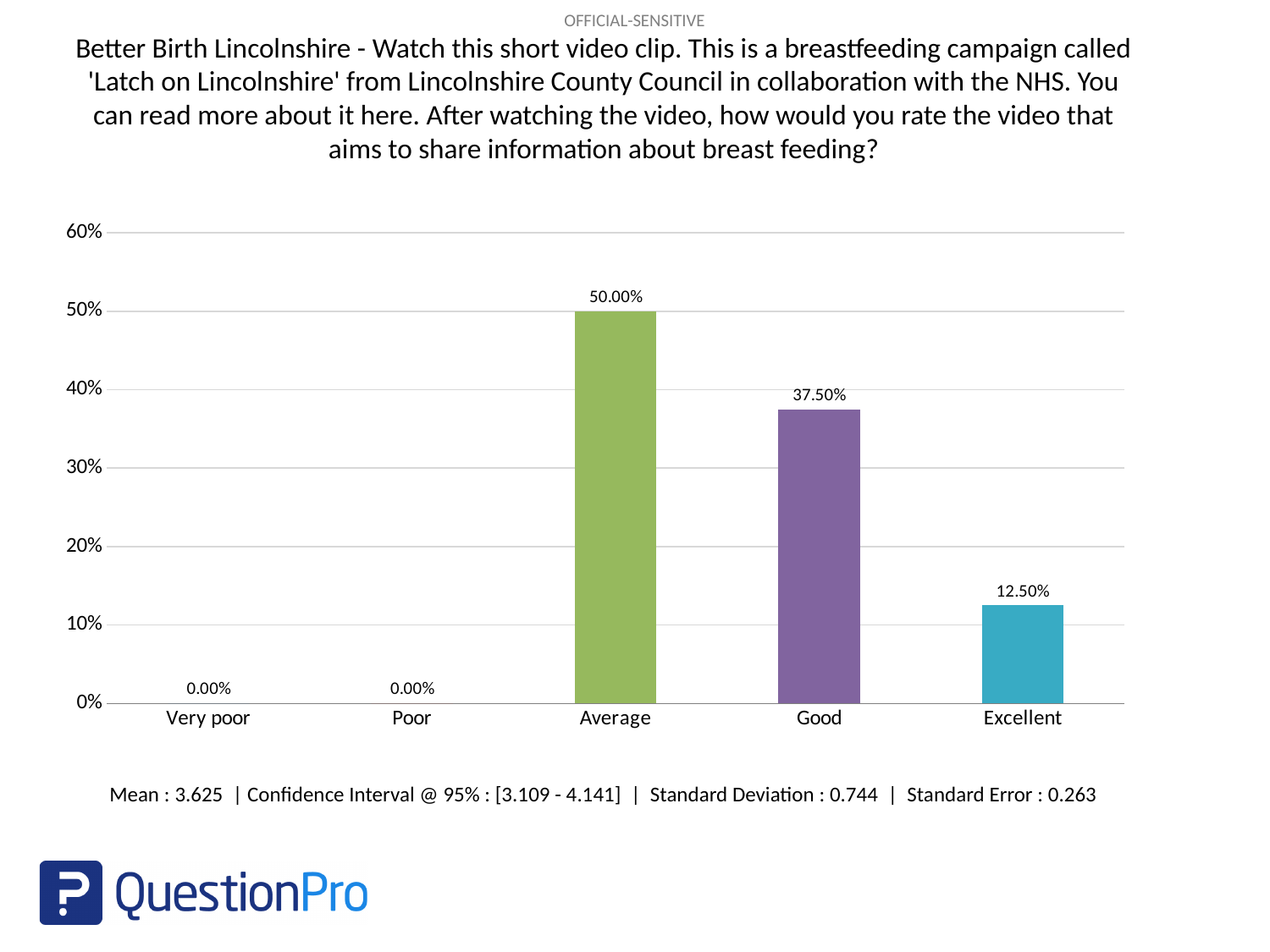
Which rating category has the highest percentage? Average What percentage of respondents rated the video as Average? 50.00% Which is larger, the percentage for Good or the percentage for Excellent? Good What percentage of respondents rated the video as Excellent? 12.50% How many rating categories are shown on the x axis? 5 What kind of chart is shown on the slide? Bar chart What is the mean value reported below the chart? 3.625 Is the value for Good greater or less than 40%? less What is the difference in percentage points between the Good and Excellent ratings? 25.00% What is the difference in percentage points between the Average and Good ratings? 12.50% What percentage of respondents rated the video as Very poor? 0.00% What percentage of respondents rated the video as Good? 37.50%